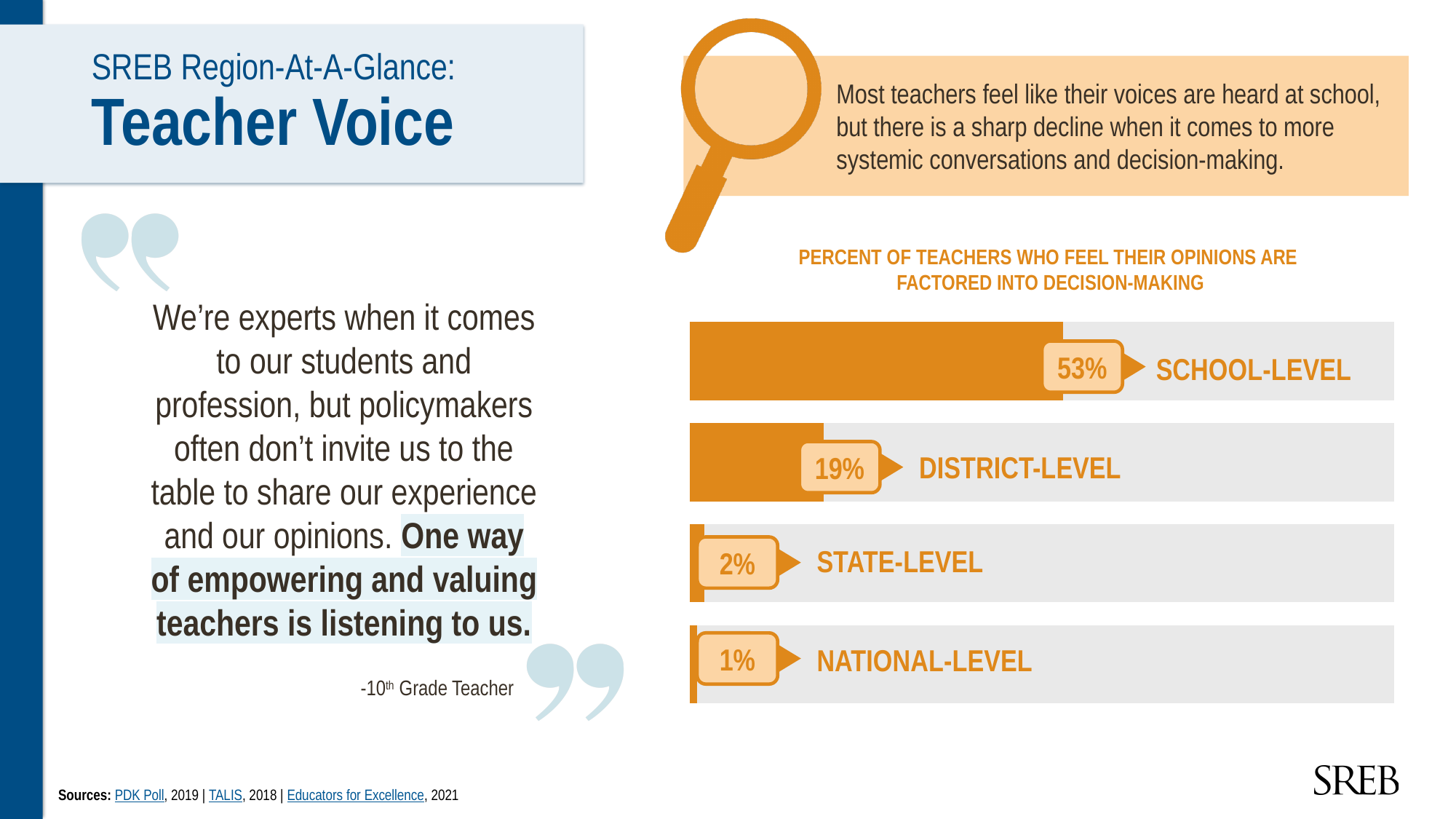
What is the difference in percentage points between the school-level and district-level values? 34 At which level do the most teachers feel their opinions are factored into decision-making? School-level What percent of teachers feel their opinions are factored into state-level decision-making? 2% What percent of teachers feel their opinions are factored into district-level decision-making? 19% What is the difference in percentage points between the state-level and national-level values? 1 What kind of chart is used to show the percent of teachers who feel their opinions are factored into decision-making? Bar chart What is the title of the chart on the right side of the slide? Percent of teachers who feel their opinions are factored into decision-making What percent of teachers feel their opinions are factored into national-level decision-making? 1% What percent of teachers feel their opinions are factored into school-level decision-making? 53% Which is larger, the district-level value or the state-level value? District-level At which level do the fewest teachers feel their opinions are factored into decision-making? National-level How many levels of decision-making are shown in the chart? 4